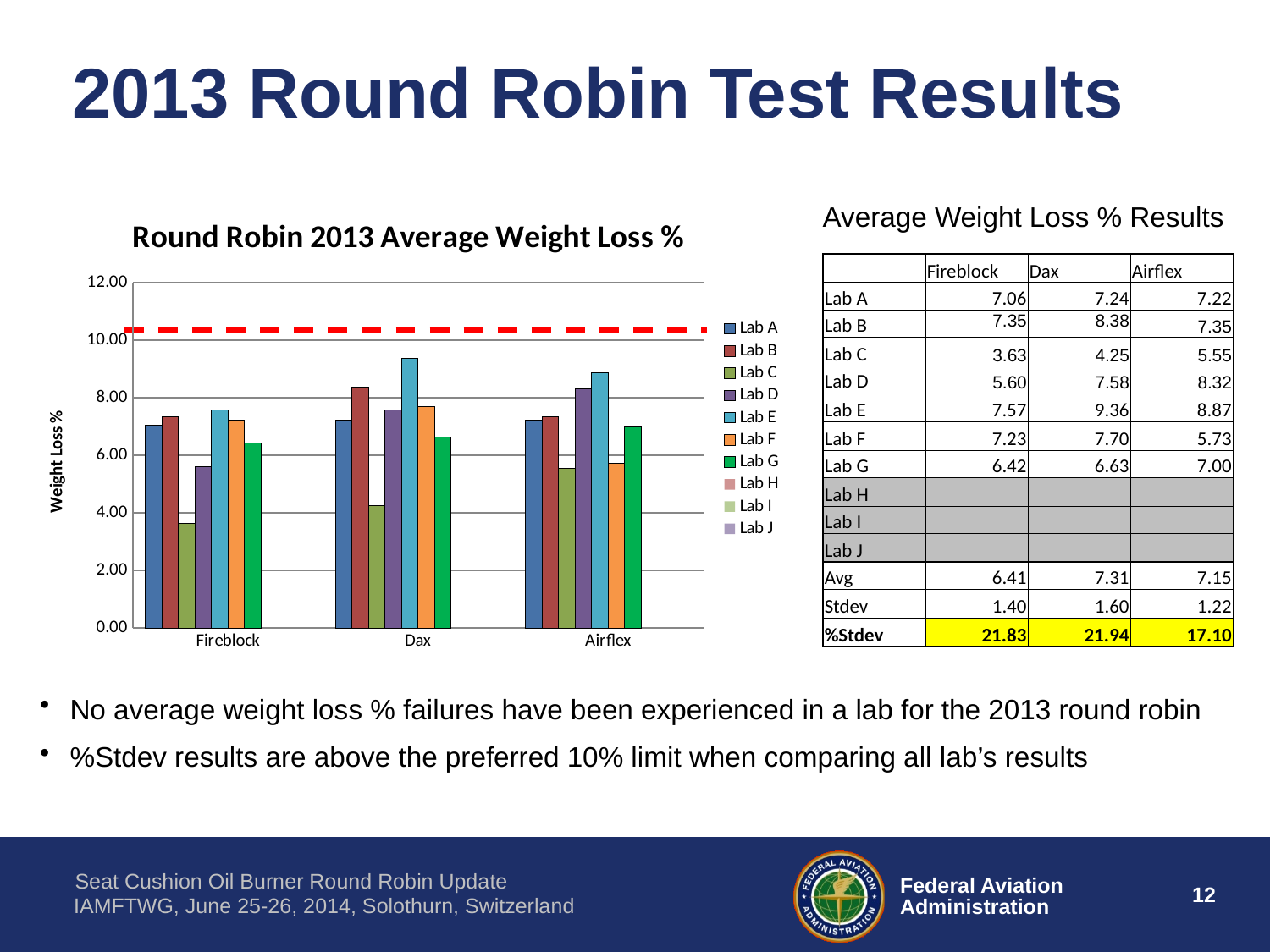
Which lab has the lowest bar in the Fireblock category? Lab C What kind of chart is shown on the slide? Bar chart What is the label on the y axis of the chart? Weight Loss % How many categories are shown on the x axis of the chart? 3 What is the title of the chart? Round Robin 2013 Average Weight Loss % Do Lab C's values rise or fall moving from Fireblock to Dax to Airflex? Rise Which lab has the highest bar in the Airflex category? Lab E Is the value for Lab E in the Dax category greater or less than 8.00? greater How many series does the chart legend list? 10 Which lab has the highest bar in the Dax category? Lab E Is the value for Lab C in the Fireblock category greater or less than 4.00? less Which is larger: Lab B's value for Dax or Lab B's value for Fireblock? Dax